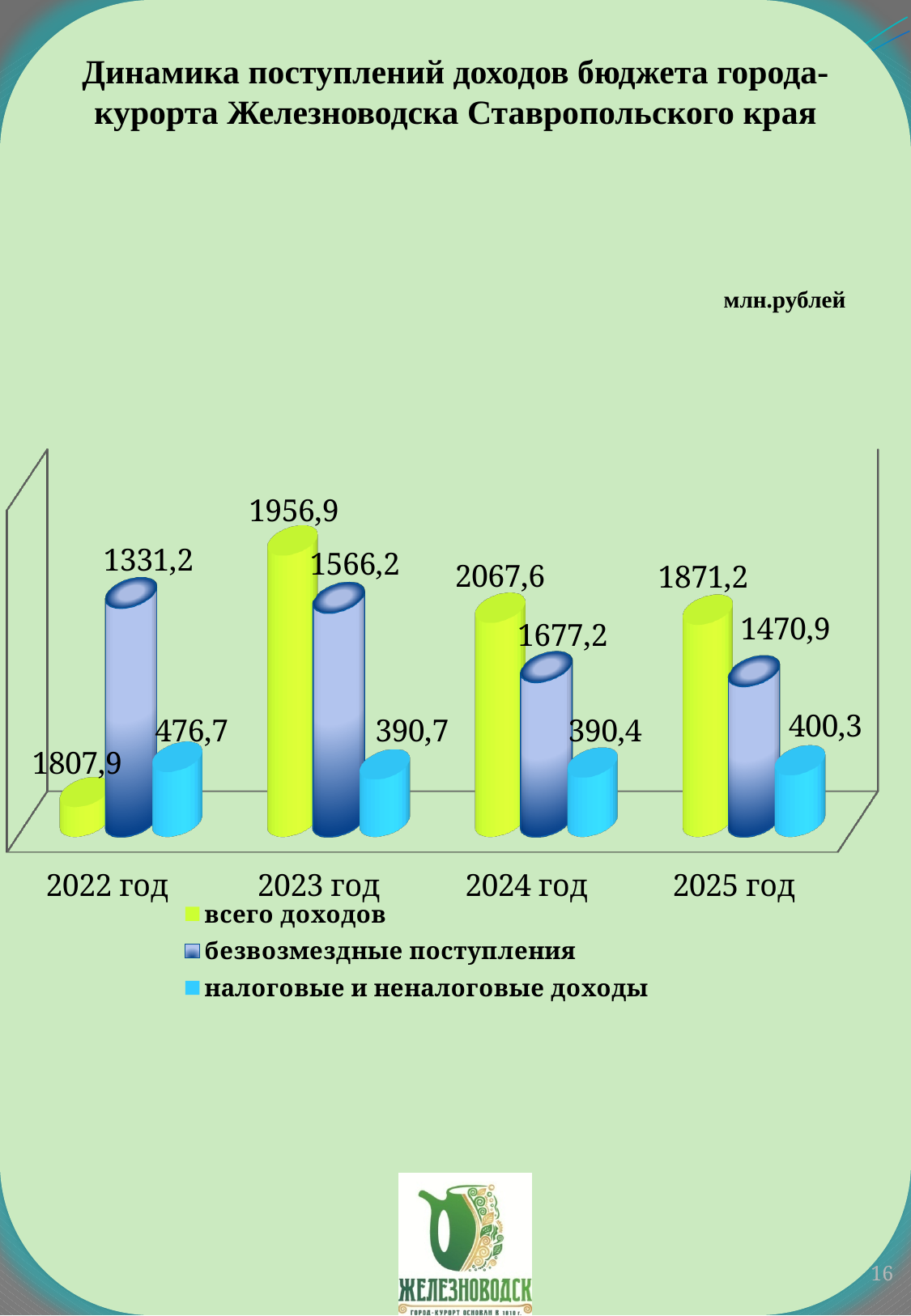
What unit of measurement is indicated above the chart? млн.рублей In which year is "всего доходов" the highest? 2024 год In which year is "налоговые и неналоговые доходы" the lowest? 2024 год What kind of chart is shown on the slide? bar chart How many series does the legend list? 3 What is the value of "налоговые и неналоговые доходы" for 2022 год? 476,7 What is the difference between "всего доходов" in 2024 год and 2025 год? 196,4 Which is larger: "безвозмездные поступления" in 2023 год or in 2025 год? 2023 год How many years are shown on the x axis? 4 What is the value of "безвозмездные поступления" for 2024 год? 1677,2 What is the value of "безвозмездные поступления" for 2025 год? 1470,9 What is the value of "всего доходов" for 2023 год? 1956,9